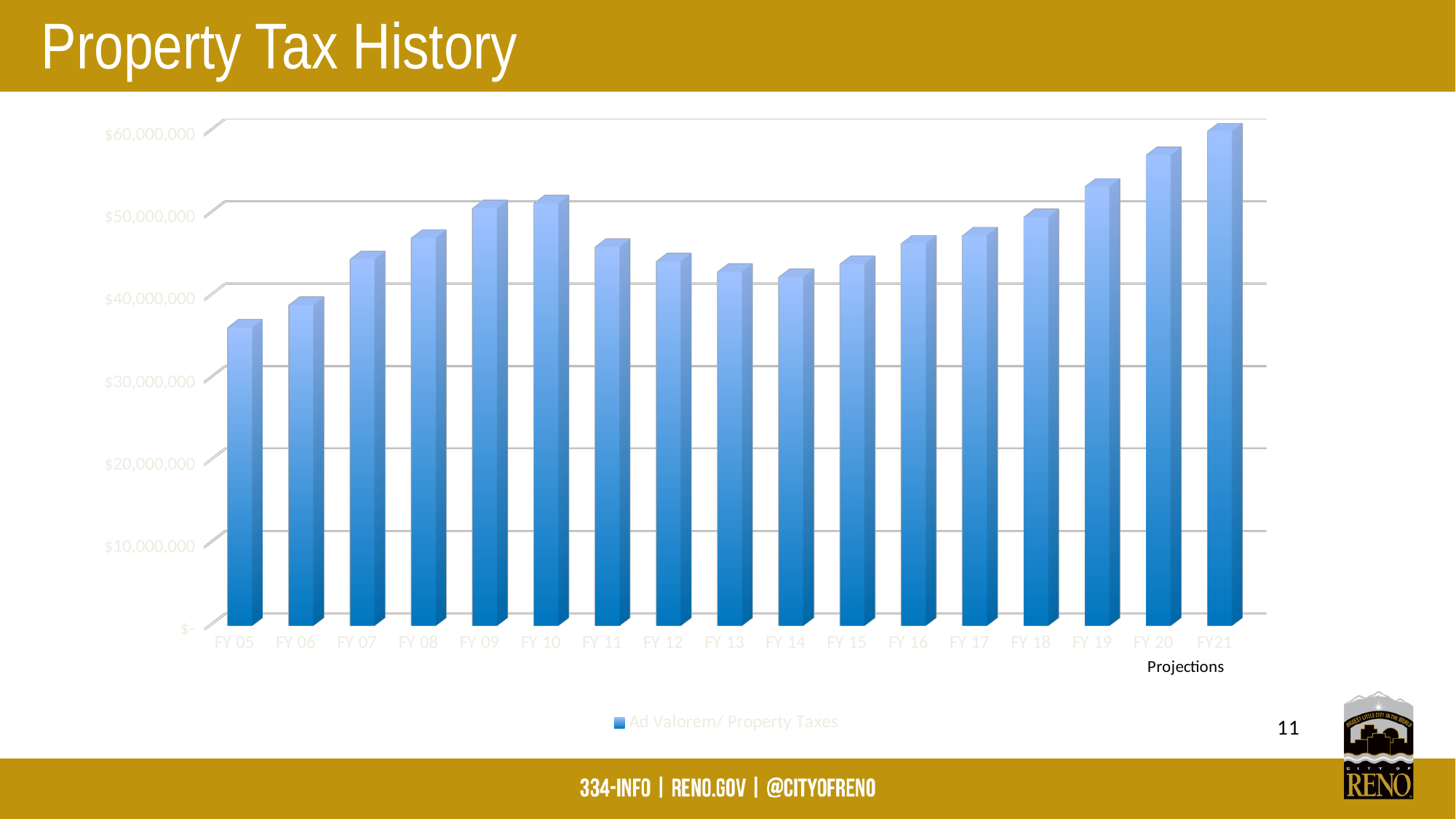
What kind of chart is shown on the slide? Bar chart Do the values rise or fall from FY 14 to FY21? rise Which fiscal year has the lowest property tax value? FY 05 Is the value for FY 14 greater or less than $40,000,000? greater Is the value for FY 05 greater or less than $40,000,000? less Is the value for FY 20 greater or less than $50,000,000? greater How many fiscal years are plotted on the chart? 17 What is the legend entry for the series plotted on the chart? Ad Valorem/ Property Taxes Which is larger, the value for FY 10 or the value for FY 11? FY 10 Which fiscal year has the highest property tax value? FY21 How many series does the legend list? 1